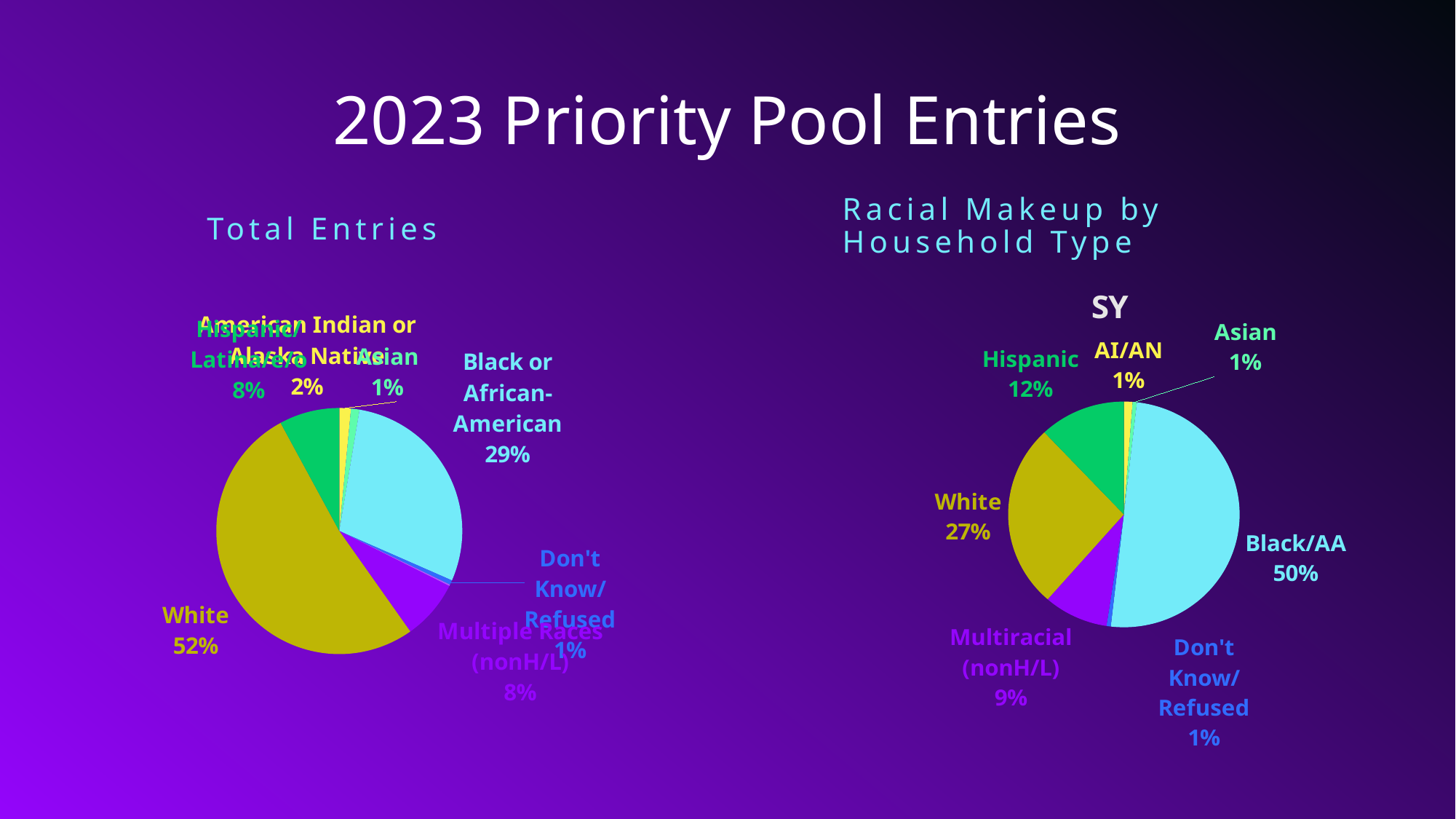
In the Total Entries chart, what share is Multiple Races (nonH/L)? 8% In the SY chart, which is larger, the White share or the Multiracial (nonH/L) share? White In the SY chart, what share is White? 27% In the Total Entries chart, which category has the largest share? White In the Total Entries chart, what share of entries is White? 52% In the Total Entries chart, what share of entries is Black or African-American? 29% In the SY chart, what share is Hispanic? 12% What type of chart is the Total Entries chart? pie chart How many slices does the SY pie chart have? 7 In the SY chart, which category has the largest share? Black/AA In the SY chart, what share is Black/AA? 50% In the Total Entries chart, what is the difference between the White share and the Black or African-American share? 23%